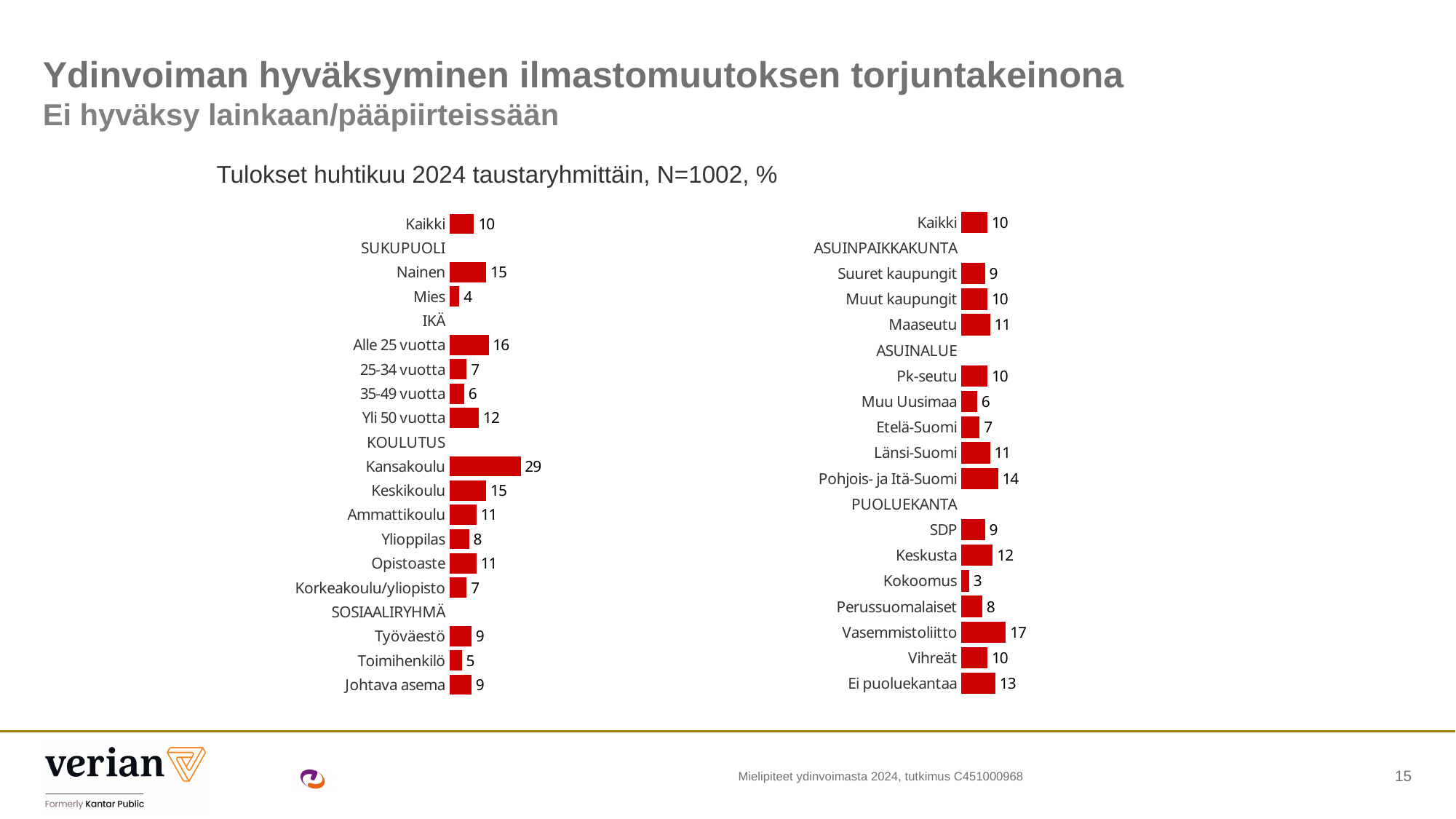
In the right chart, what is the difference between the values for Pohjois- ja Itä-Suomi and Muu Uusimaa? 8 In the right chart, what is the value for Vasemmistoliitto? 17 In the left chart, what is the value for Toimihenkilö? 5 In the left chart, what is the value for Kansakoulu? 29 In the left chart, which category has the highest value? Kansakoulu In the right chart, which category has the lowest value? Kokoomus In the left chart, what is the difference between the values for Nainen and Mies? 11 In the left chart, what is the value for Alle 25 vuotta? 16 What type of chart is shown on the left side of the slide? Bar chart In the right chart, which is larger, the value for Keskusta or the value for SDP? Keskusta How many bars are plotted in the right chart? 16 What is the subtitle text shown above the charts describing the results? Tulokset huhtikuu 2024 taustaryhmittäin, N=1002, %